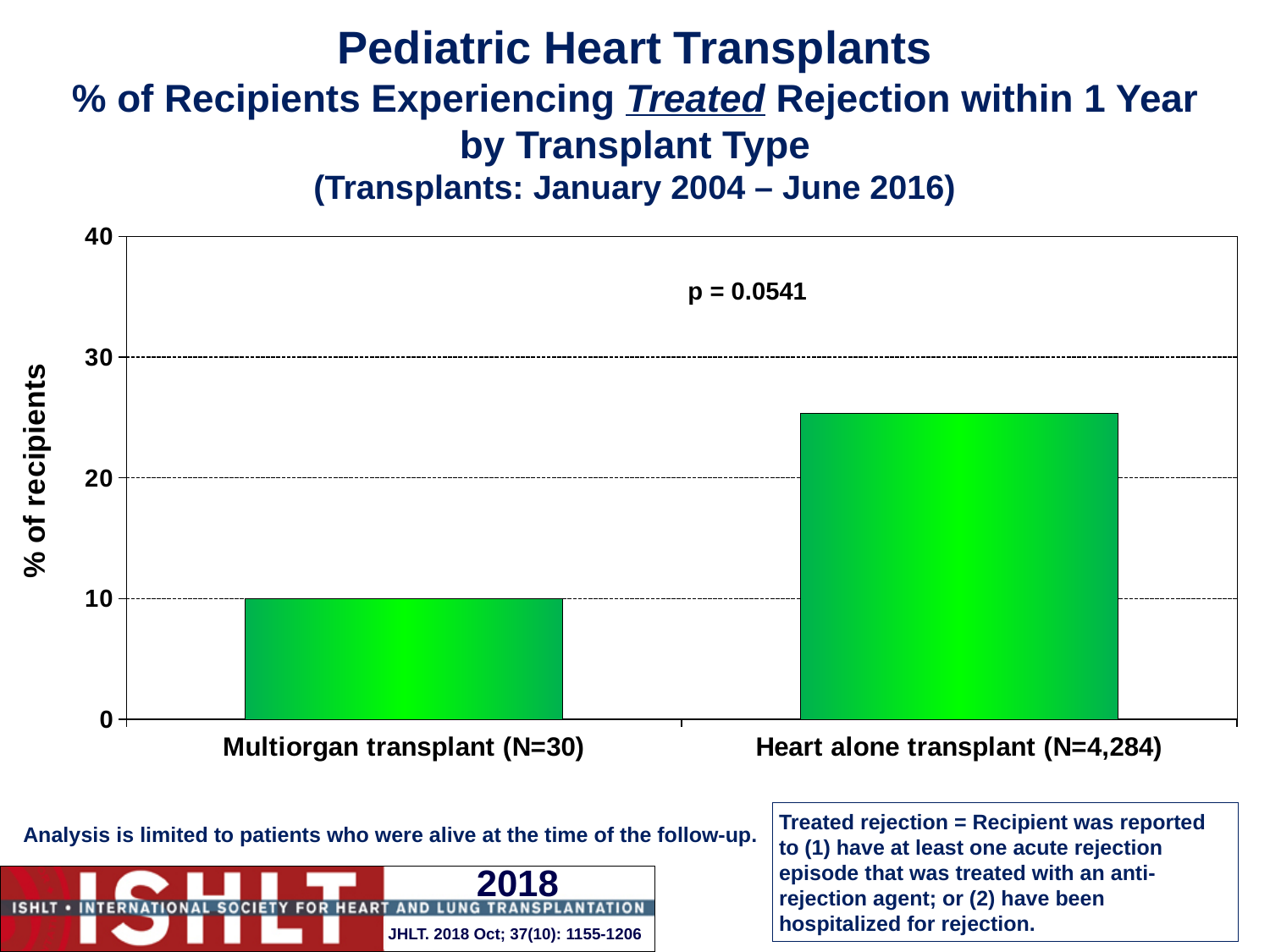
Is the value for Multiorgan transplant (N=30) greater or less than 20? less Which is larger: the value for Multiorgan transplant (N=30) or the value for Heart alone transplant (N=4,284)? Heart alone transplant (N=4,284) Is the value for Heart alone transplant (N=4,284) greater or less than 30? less What is the % of recipients experiencing treated rejection within 1 year for Multiorgan transplant (N=30)? 10 What is the label of the y axis? % of recipients How many transplant type categories are plotted on the chart? 2 Is the value for Heart alone transplant (N=4,284) greater or less than 20? greater What kind of chart is shown on the slide? bar chart What is the sample size (N) shown for the Heart alone transplant category? 4,284 What p-value is printed on the chart? p = 0.0541 Which transplant type has the lower % of recipients experiencing treated rejection within 1 year? Multiorgan transplant (N=30) Which transplant type has the higher % of recipients experiencing treated rejection within 1 year? Heart alone transplant (N=4,284)